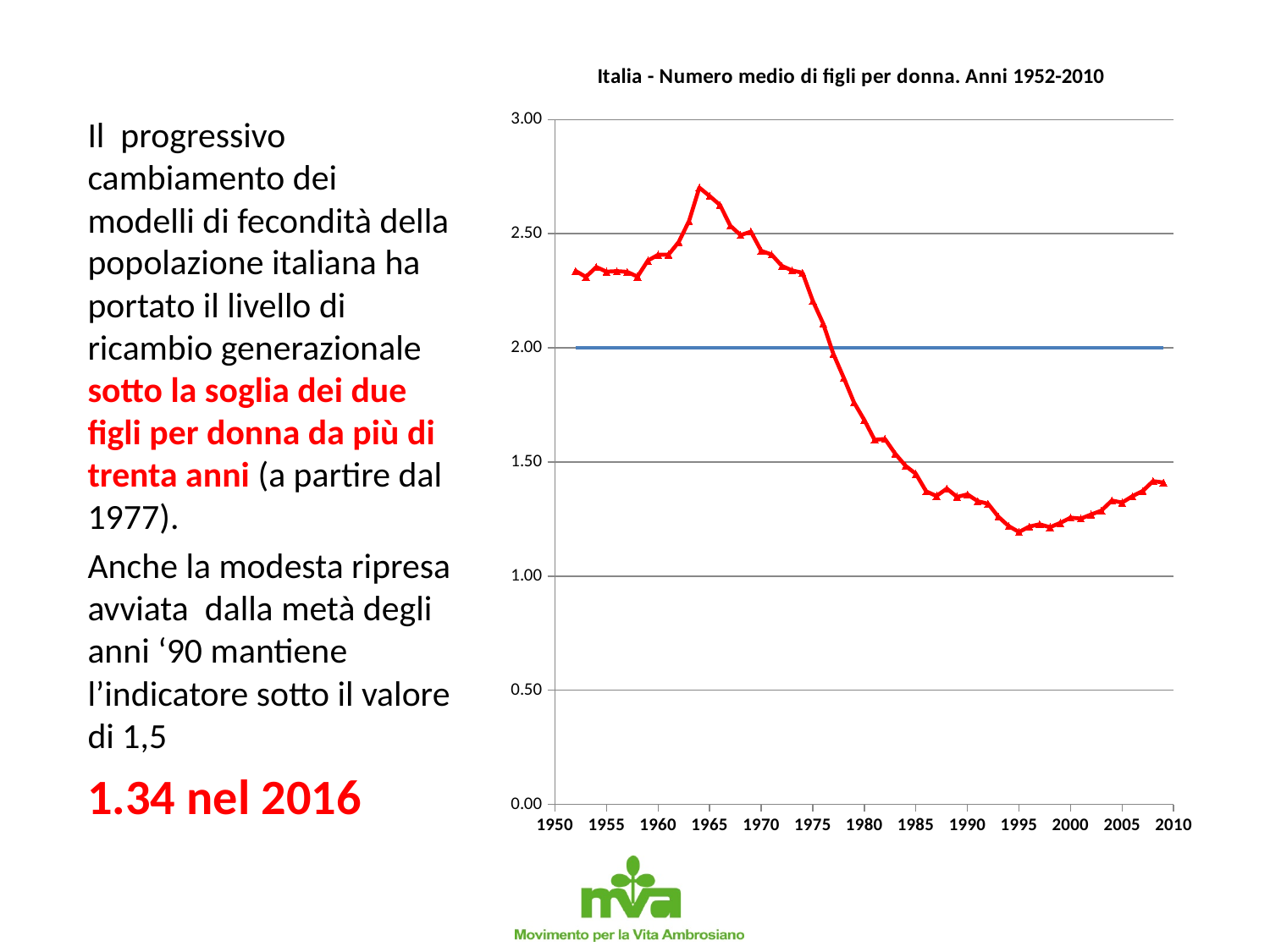
At what value on the y axis is the horizontal blue line drawn? 2.00 Near which labelled year on the x axis does the red line reach its lowest value? 1995 Is the value of the red line in 1965 greater or less than 2.50? greater Is the value of the red line in 1995 greater or less than 1.50? less Is the value of the red line in 2010 greater or less than 1.50? less What kind of chart is shown on the slide? line chart What is the title of the chart? Italia - Numero medio di figli per donna. Anni 1952-2010 Does the red line rise or fall between 1965 and 1995? fall Which is larger, the value of the red line in 1955 or in 1985? 1955 Does the red line rise or fall between 1995 and 2010? rise